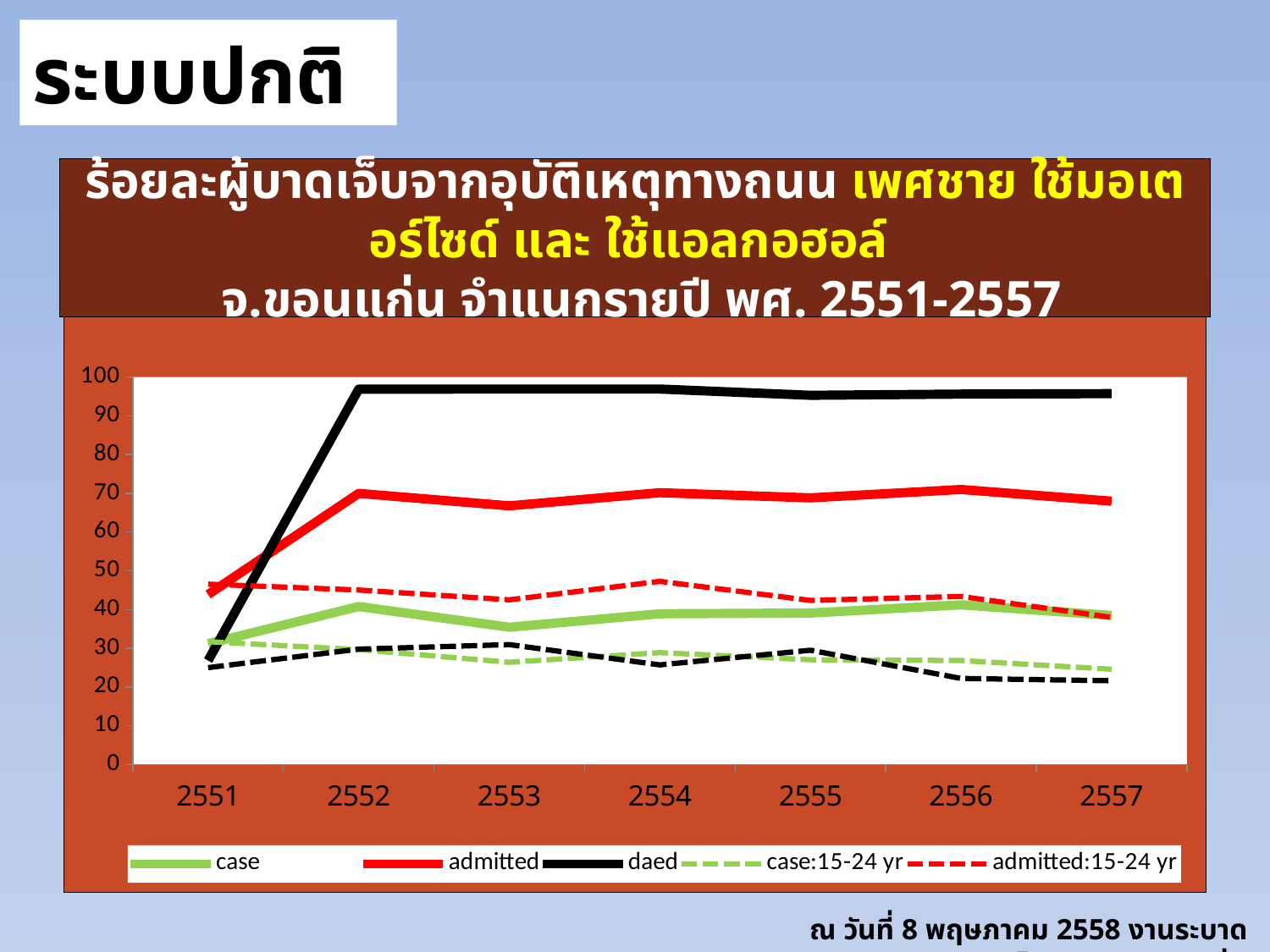
Which series has the highest value in 2554? daed In which year is the 'daed' series at its lowest? 2551 Is the value for the 'daed' series in 2551 greater or less than 30? less What colour is the line for the 'admitted' series? red How many series does the chart legend list? 5 Does the 'daed' series rise or fall from 2551 to 2552? rise In 2557, which is larger: the 'admitted' series or the 'case' series? admitted How many years are shown on the x axis of the chart? 7 Is the value for the 'daed' series in 2552 greater or less than 90? greater What kind of chart is shown on the slide? line chart Is the value for the 'admitted' series in 2552 greater or less than 60? greater